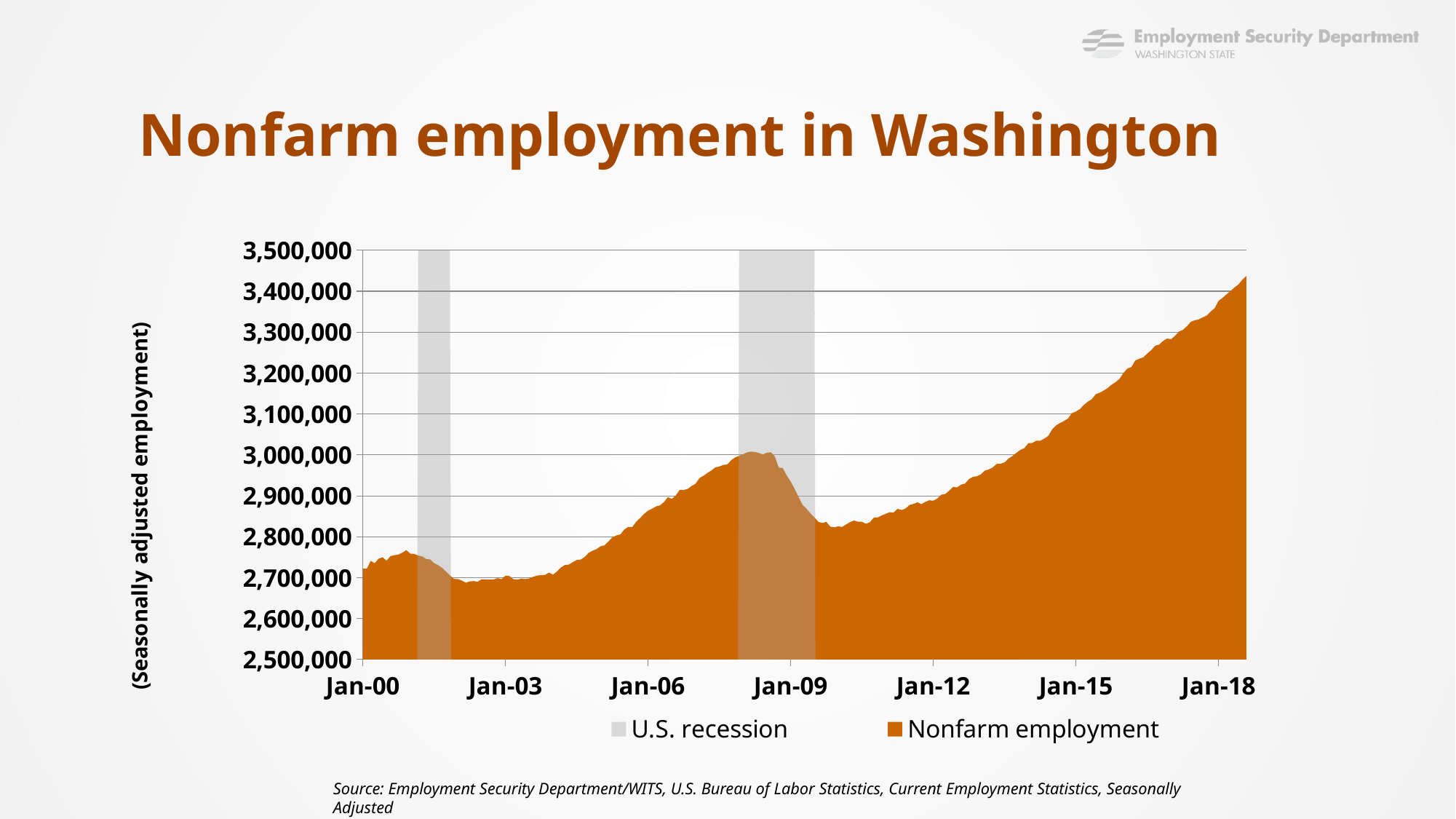
Does nonfarm employment rise or fall between Jan-00 and Jan-03? Fall Is the nonfarm employment value at Jan-00 greater or less than 2,800,000? less Does nonfarm employment rise or fall between Jan-12 and Jan-18? Rise What is the label on the vertical axis? (Seasonally adjusted employment) Is the nonfarm employment value at Jan-12 greater or less than 2,800,000? greater How many entries does the legend list? 2 Which is larger, the nonfarm employment value at Jan-18 or at Jan-09? Jan-18 Is the nonfarm employment value at Jan-15 greater or less than 3,100,000? greater What is the title of the chart? Nonfarm employment in Washington What kind of chart is shown on the slide? Area chart